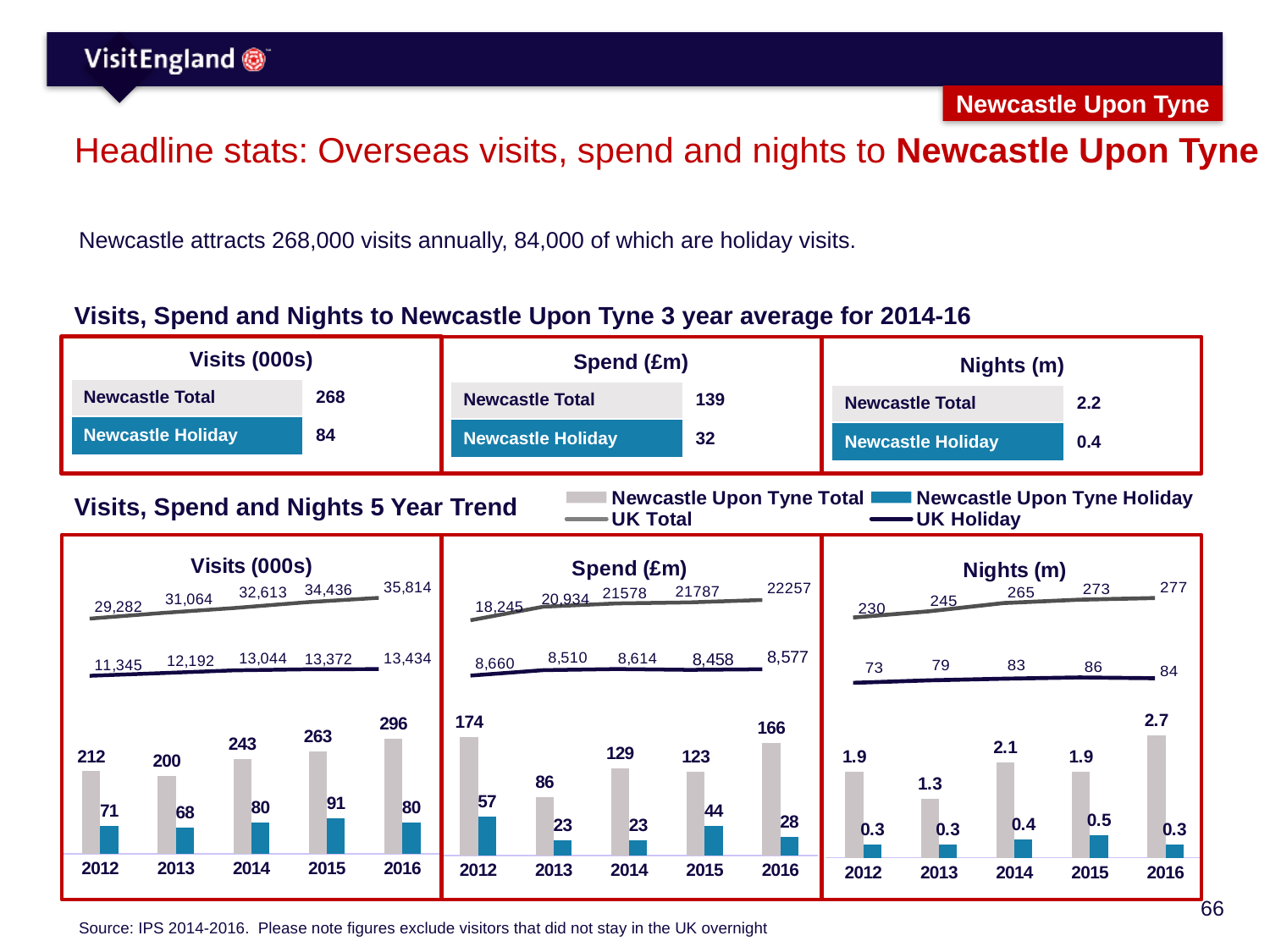
In the Nights (m) 5 year trend chart, what is the UK Holiday value for 2014? 83 What kind of chart is used for the Newcastle Upon Tyne Total and Holiday values in the Nights (m) 5 year trend chart? Bar chart In the Visits (000s) 5 year trend chart, does the UK Total line rise or fall from 2012 to 2016? Rise In the Spend (£m) 5 year trend chart, which year has the lowest Newcastle Upon Tyne Holiday value? 2013 and 2014 In the Visits (000s) 5 year trend chart, what is the Newcastle Upon Tyne Total value for 2016? 296 In the Visits (000s) 5 year trend chart, is the Newcastle Upon Tyne Total value larger in 2014 or 2013? 2014 In the Nights (m) 5 year trend chart, what is the difference between the Newcastle Upon Tyne Total values for 2016 and 2013? 1.4 In the Spend (£m) 5 year trend chart, which year has the highest Newcastle Upon Tyne Total value? 2012 In the Spend (£m) 5 year trend chart, what is the UK Total value for 2016? 22257 In the Visits (000s) 5 year trend chart, what is the Newcastle Upon Tyne Holiday value for 2015? 91 How many series does the legend for the 5 Year Trend charts list? 4 How many years are shown on the x axis of the Spend (£m) 5 year trend chart? 5